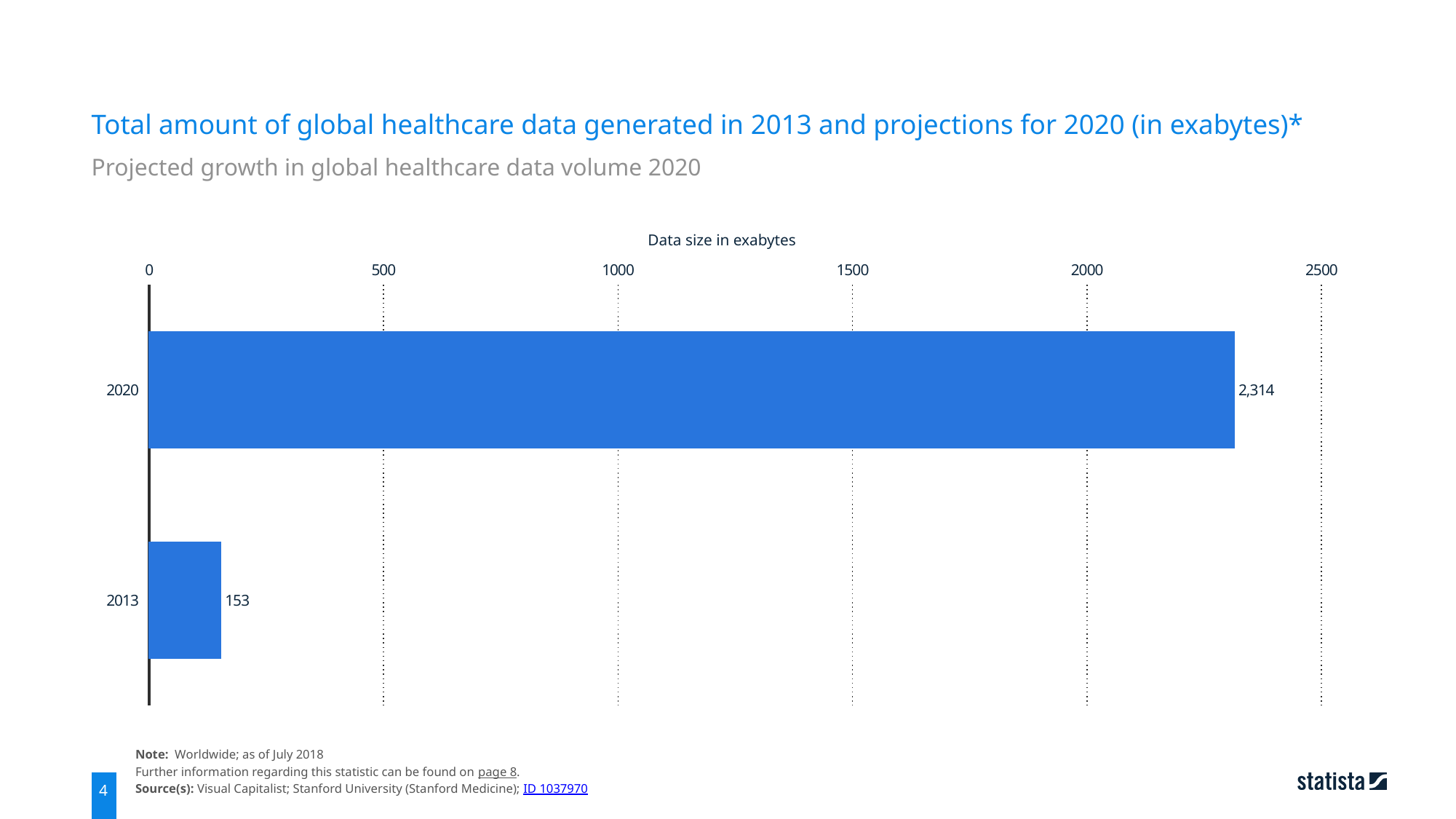
What is the value for 2020? 2,314 Which is larger, the value for 2020 or the value for 2013? 2020 What is the value for 2013? 153 Which year has the lowest value? 2013 Is the value for 2013 greater or less than 500? less What kind of chart is shown on the slide? bar chart What is the subtitle of the chart? Projected growth in global healthcare data volume 2020 How many categories are shown in the chart? 2 What is the difference between the values for 2020 and 2013? 2,161 Is the value for 2020 greater or less than 2000? greater What is the axis title shown above the chart? Data size in exabytes Which year has the highest value? 2020